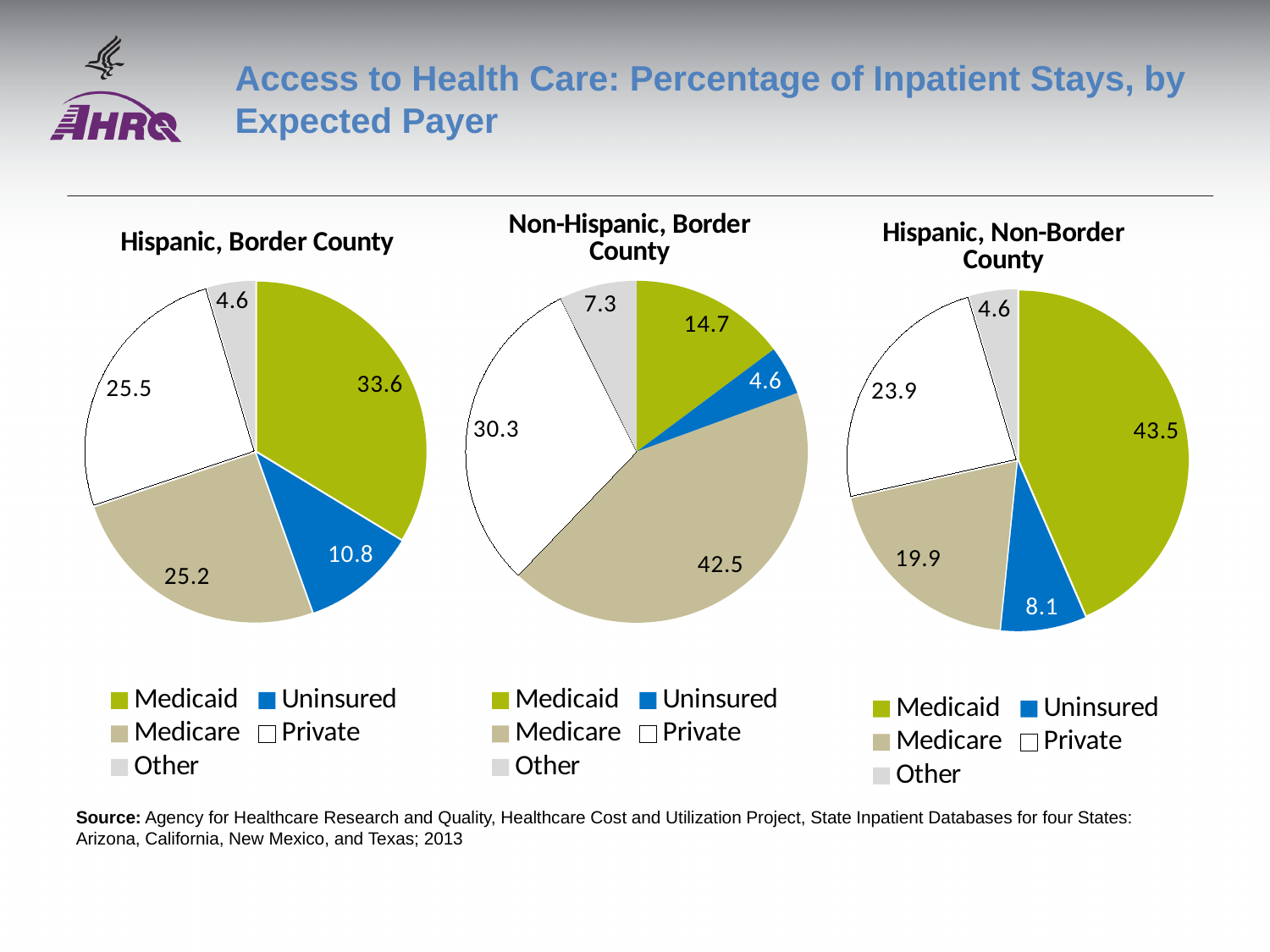
In the Non-Hispanic, Border County chart, which payer has the smallest slice? Uninsured In the Hispanic, Border County chart, which payer has the smallest slice? Other In the Hispanic, Non-Border County chart, what is the difference between the Private and Medicare values? 4.0 In the Hispanic, Non-Border County chart, which payer has the largest slice? Medicaid In the Hispanic, Border County chart, what is the difference between the Medicaid and Uninsured values? 22.8 In the Non-Hispanic, Border County chart, what is the value for Medicare? 42.5 In the Hispanic, Border County chart, what is the value for Medicaid? 33.6 In the Non-Hispanic, Border County chart, which is larger, Private or Medicaid? Private In the Hispanic, Non-Border County chart, what is the value for Uninsured? 8.1 How many payer categories does each pie chart show? 5 What type of chart is used on this slide? Pie chart In the Non-Hispanic, Border County chart, what is the value for Other? 7.3